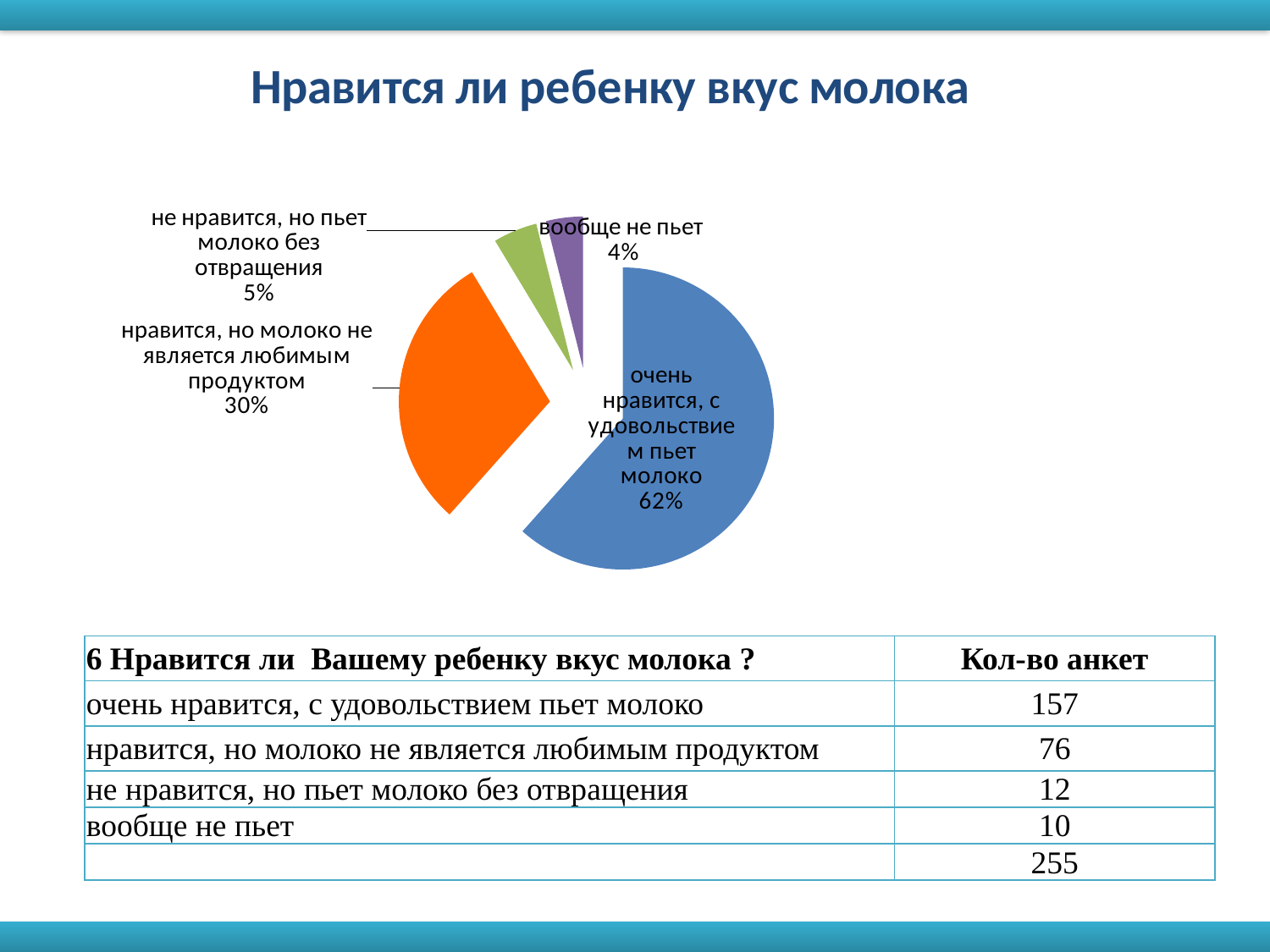
What share of the pie is labelled "не нравится, но пьет молоко без отвращения"? 5% Which slice is larger: "не нравится, но пьет молоко без отвращения" or "вообще не пьет"? не нравится, но пьет молоко без отвращения What colour is the slice labelled "нравится, но молоко не является любимым продуктом"? orange What kind of chart is shown on the slide? pie chart What share of the pie is labelled "вообще не пьет"? 4% What is the difference in percentage points between the "очень нравится, с удовольствием пьет молоко" slice and the "нравится, но молоко не является любимым продуктом" slice? 32 Which slice of the pie chart is the largest? очень нравится, с удовольствием пьет молоко What is the title of the slide above the pie chart? Нравится ли ребенку вкус молока What share of the pie is labelled "очень нравится, с удовольствием пьет молоко"? 62% How many slices does the pie chart have? 4 Which slice of the pie chart is the smallest? вообще не пьет